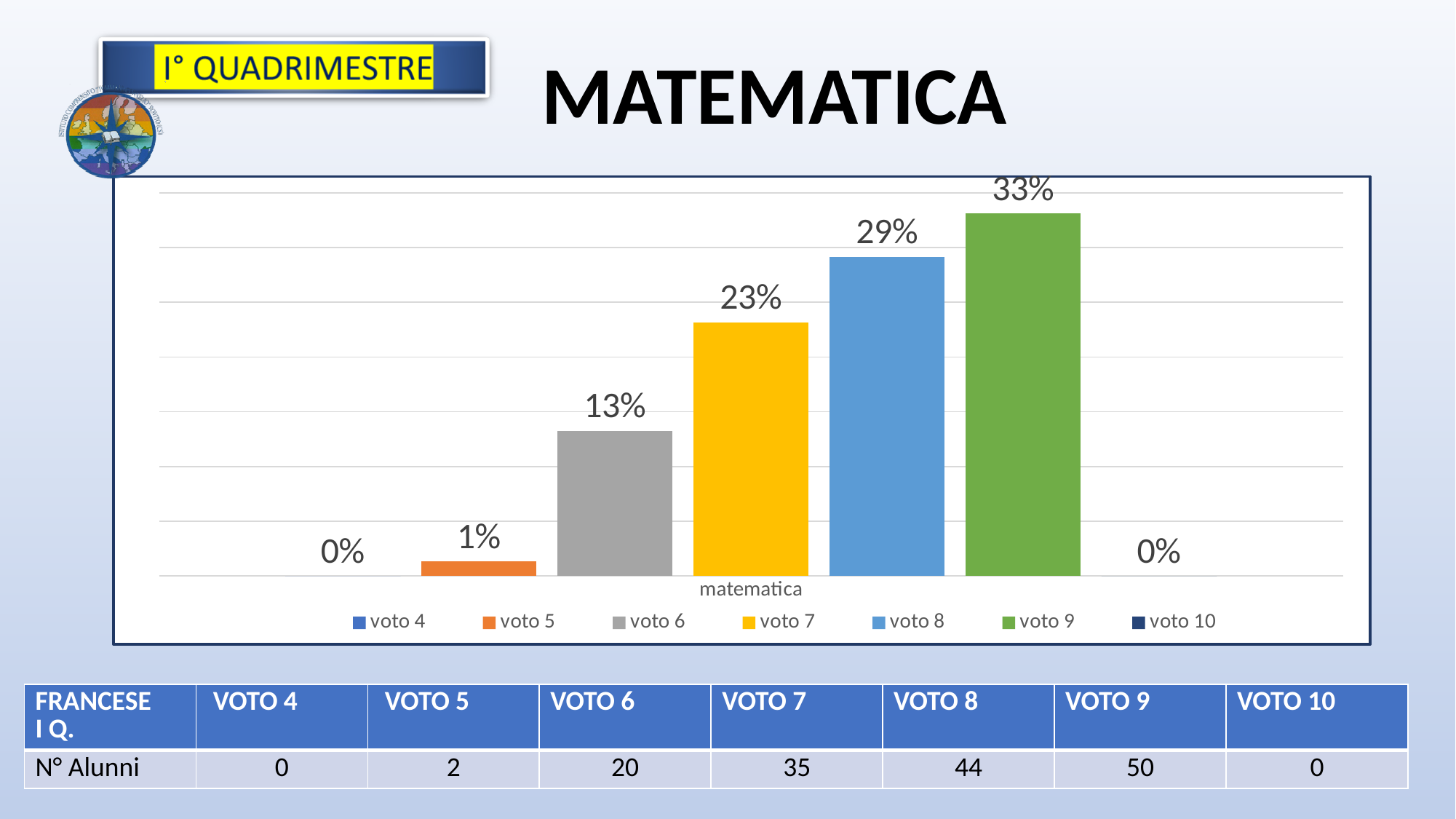
What percentage is shown for voto 5? 1% What percentage is shown for voto 6? 13% What percentage is shown for voto 7? 23% Which has a larger percentage, voto 8 or voto 7? voto 8 What is the category label shown under the bars on the x axis? matematica How many series does the legend list? 7 What kind of chart is shown on the slide? bar chart What is the difference in percentage points between voto 7 and voto 6? 10% What colour is the bar for voto 7? yellow What is the difference in percentage points between voto 9 and voto 8? 4% Which voto has the highest percentage in the chart? voto 9 What percentage is shown for voto 9? 33%